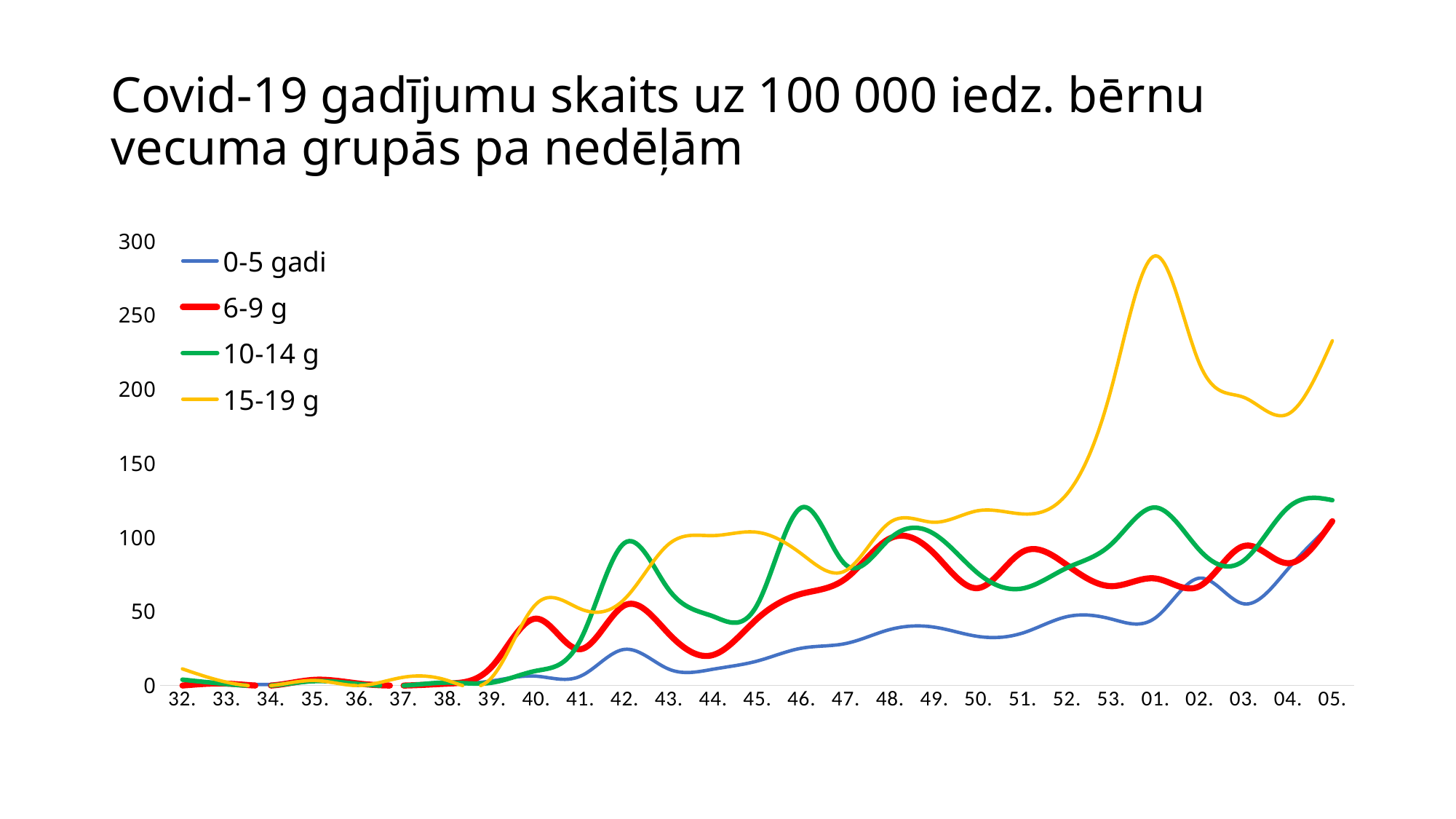
What colour is the line for the 6-9 g series? red Which age group has the highest value in week 01.? 15-19 g What kind of chart is shown on the slide? line chart In week 46., which is larger: the value for 10-14 g or the value for 0-5 gadi? 10-14 g Which age group has the lowest value in week 45.? 0-5 gadi How many weeks are shown along the x axis? 27 Is the value for 15-19 g in week 04. greater or less than 200? less Is the value for 0-5 gadi in week 42. greater or less than 50? less How many series does the legend list? 4 Is the value for 15-19 g in week 01. greater or less than 250? greater Does the 15-19 g line generally rise or fall from week 32. to week 01.? rise